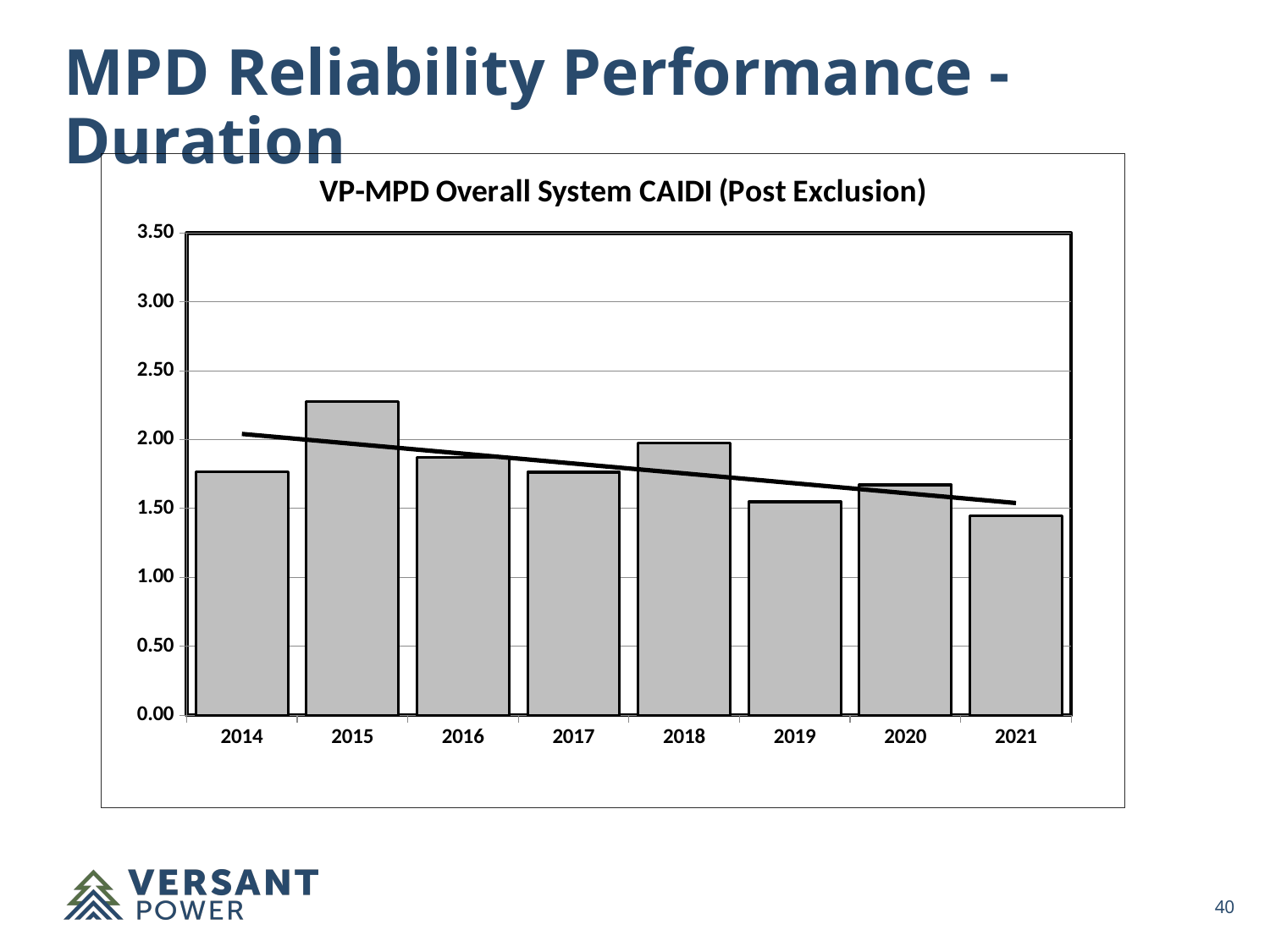
Is the value for 2020 greater or less than 1.50? greater Does the trend line drawn across the bars rise or fall from 2014 to 2021? Fall Which year has the lowest CAIDI value? 2021 Is the value for 2016 greater or less than 2.00? less Which year has a higher value, 2015 or 2018? 2015 Which year has the highest CAIDI value? 2015 What is the title of the chart? VP-MPD Overall System CAIDI (Post Exclusion) What kind of chart is shown on the slide? Bar chart How many years are shown on the x axis of the chart? 8 Is the value for 2021 greater or less than 1.50? less Which year has a higher value, 2019 or 2020? 2020